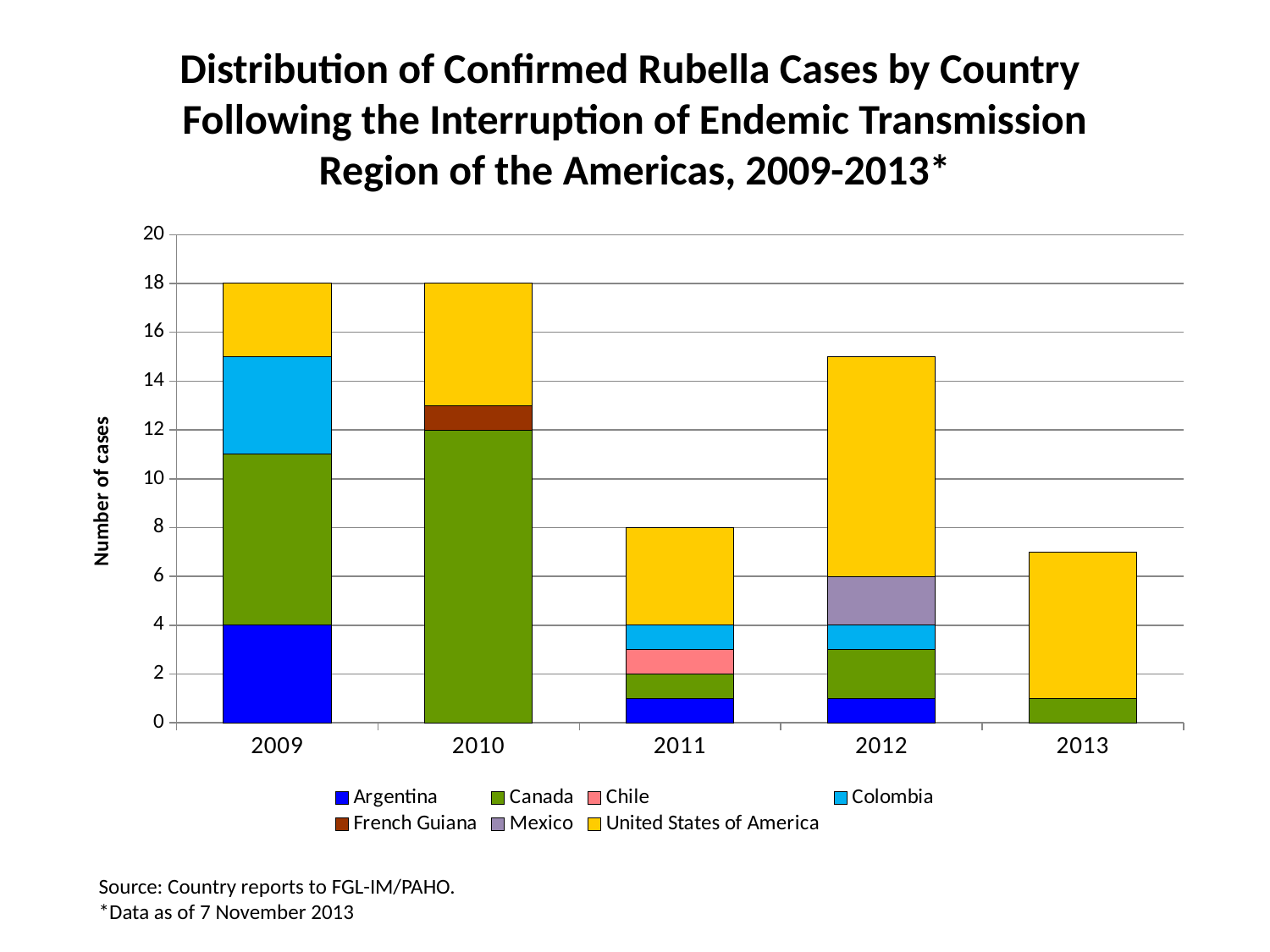
Which year has a larger total number of cases, 2011 or 2012? 2012 Is the total number of cases in 2013 greater or less than 8? less What kind of chart is shown on the slide? Stacked bar chart Which year has the lowest total number of confirmed cases? 2013 What is the total number of confirmed rubella cases in 2009? 18 Which country is the only one with cases shown in 2012 but in no other year? Mexico How many cases were reported by Canada in 2010? 12 Is the total number of cases in 2012 greater or less than 14? greater How many years are shown on the x axis? 5 How many cases were reported by Argentina in 2009? 4 What is the total number of confirmed rubella cases in 2011? 8 How many countries does the legend list? 7